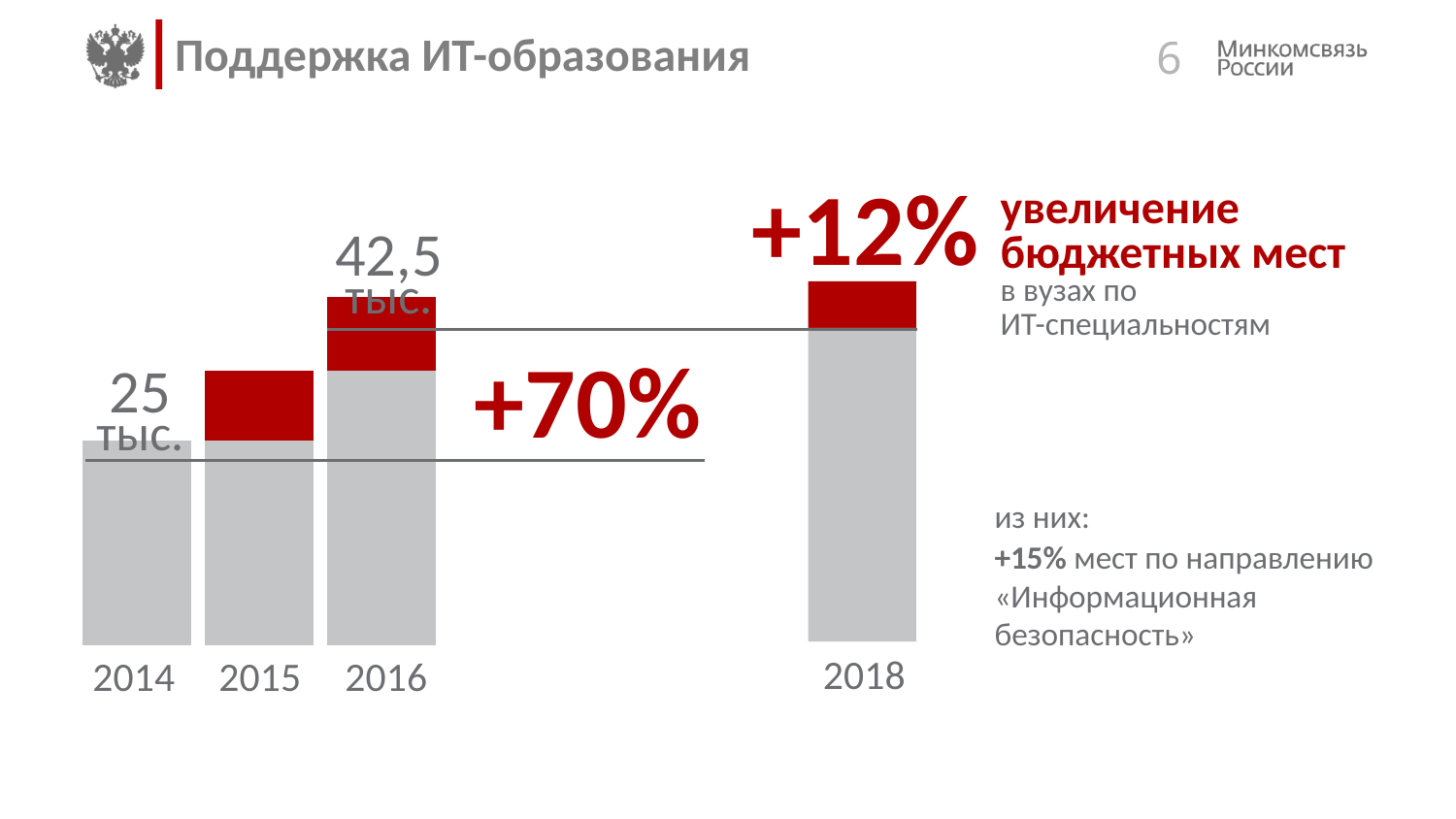
Which year has the tallest bar? 2018 What percentage increase is annotated between 2014 and 2016? +70% What kind of chart is shown on the slide? bar chart What percentage increase is annotated for 2018? +12% What value is shown for 2014? 25 тыс. What is the difference between the 2016 value and the 2014 value? 17,5 тыс. Which is larger, the bar for 2015 or the bar for 2016? 2016 Do the bar values rise or fall from 2014 to 2018? rise Which year has the shortest bar? 2014 What value is shown for 2016? 42,5 тыс. How many years are shown on the x axis? 4